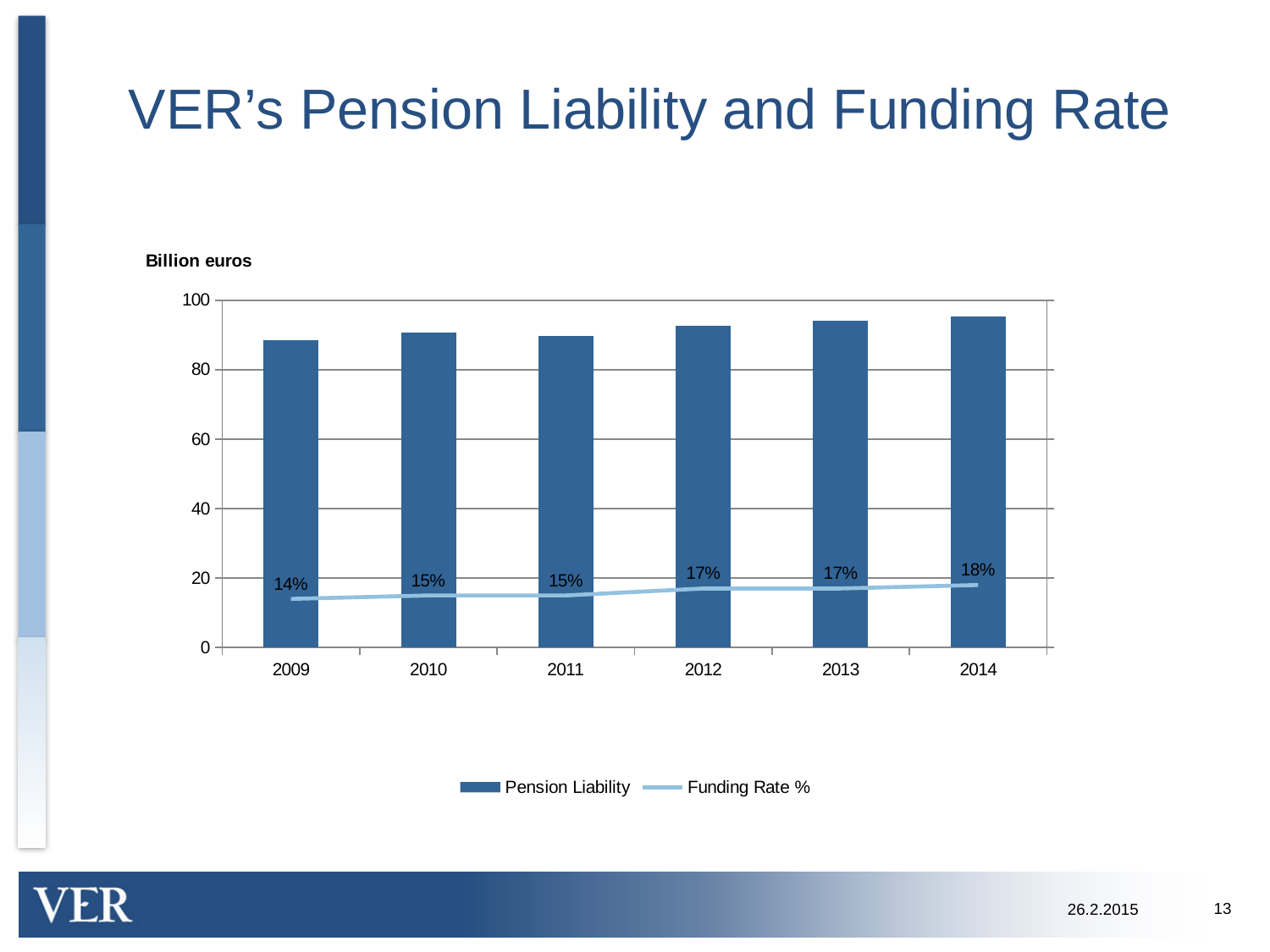
In which year is the Funding Rate % lowest? 2009 What is the Funding Rate % for 2009? 14% Is the Pension Liability larger in 2014 or in 2009? 2014 What is the Funding Rate % for 2014? 18% What is the Funding Rate % for 2012? 17% Is the Pension Liability for 2009 greater or less than 80? greater By how many percentage points did the Funding Rate % increase from 2009 to 2014? 4 percentage points Does the Funding Rate % rise or fall from 2009 to 2014? rise Is the Pension Liability for 2014 greater or less than 100? less How many years are shown on the x axis? 6 How many series does the legend list? 2 In which year is the Funding Rate % highest? 2014